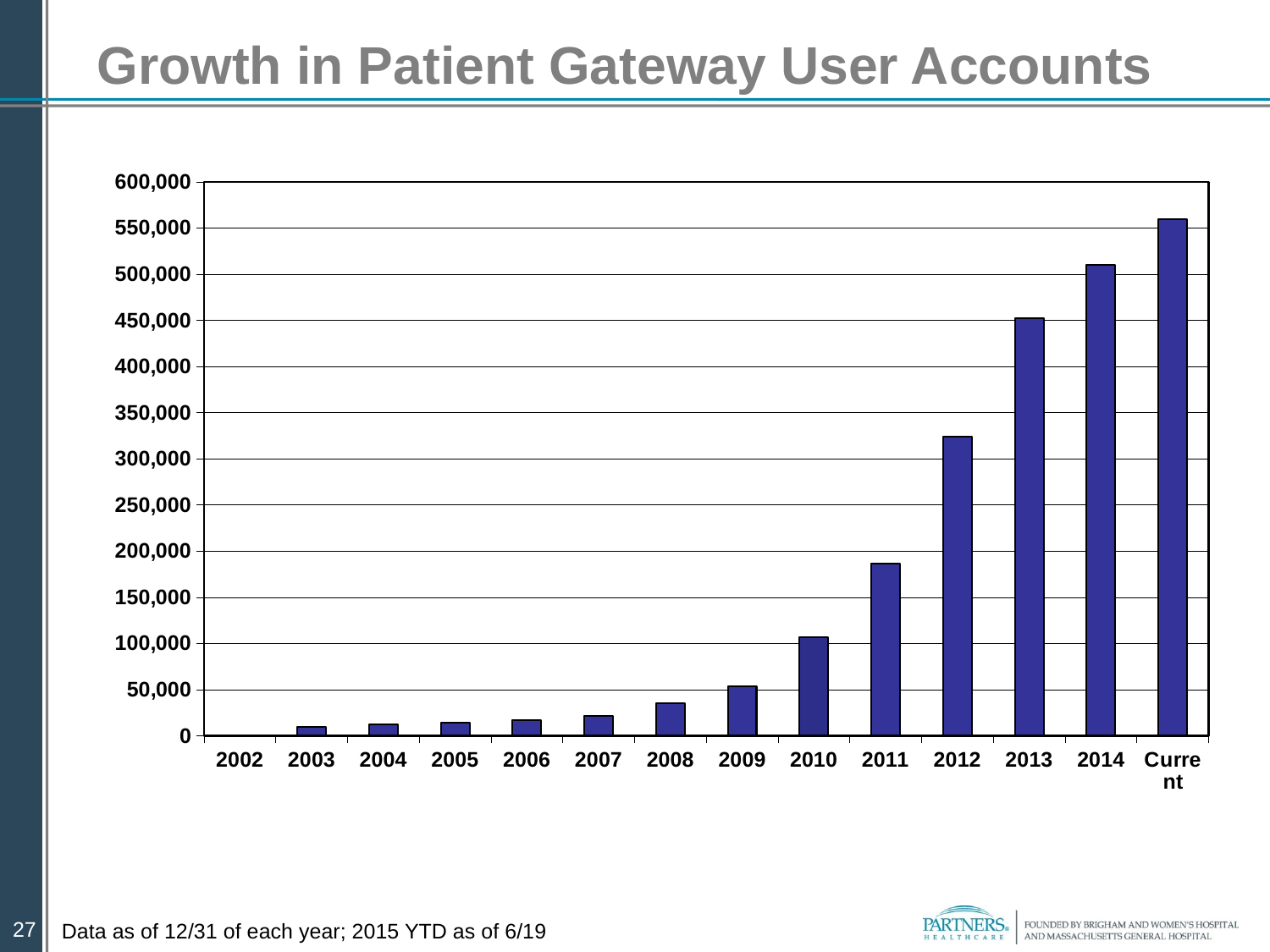
Do the values generally rise or fall from 2002 to Current? rise Is the value for 2011 greater or less than 200,000? less How many categories are shown along the x axis? 14 Is the value for Current greater or less than 550,000? greater Which category has the highest value? Current Is the value for 2012 greater or less than 300,000? greater Which is larger, the value for 2013 or the value for 2012? 2013 What kind of chart is shown on the slide? bar chart What is the title of the chart? Growth in Patient Gateway User Accounts Which category has the lowest value? 2002